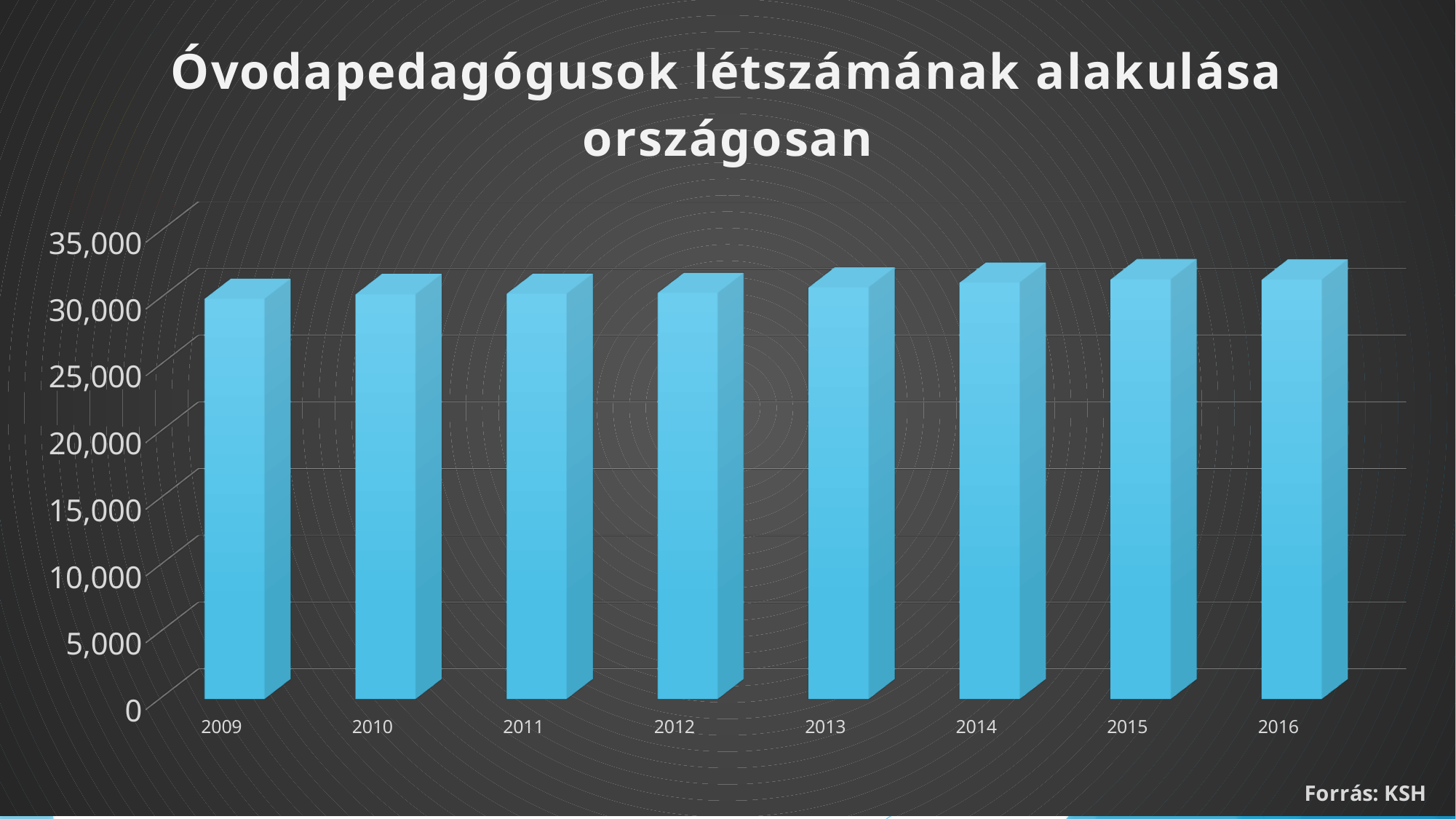
What is the title of the chart? Óvodapedagógusok létszámának alakulása országosan Do the values generally rise or fall from 2009 to 2015? rise Is the value for 2016 greater or less than 35,000? less Which year has the larger value, 2009 or 2015? 2015 What source is cited for the chart data? KSH What kind of chart is shown on the slide? bar chart Is the value for 2009 greater or less than 25,000? greater Is the value for 2012 greater or less than 20,000? greater What is the first year shown on the x axis? 2009 How many years are shown on the x axis of the chart? 8